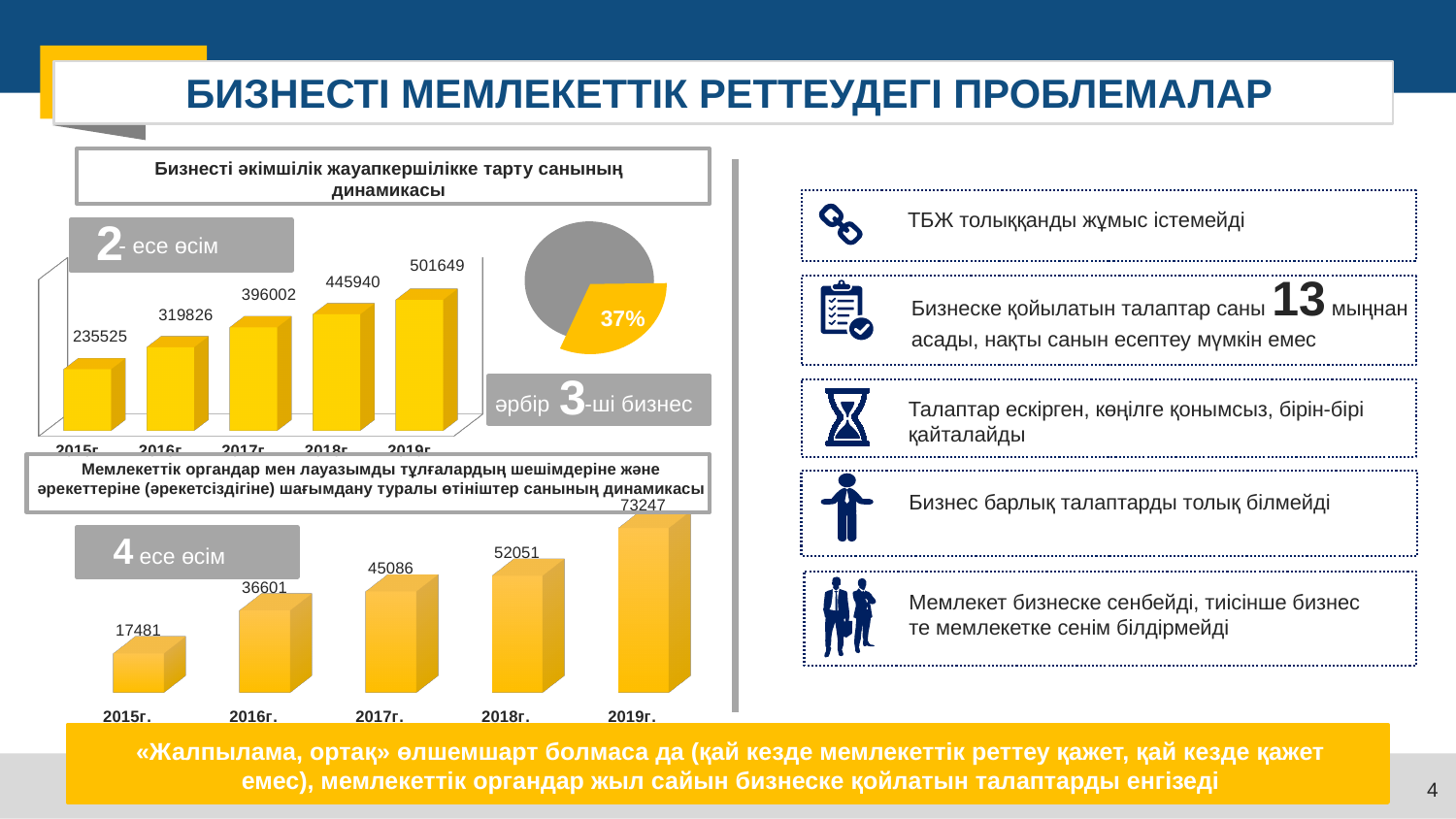
In the bottom-left bar chart, what is the value for 2016г.? 36601 In the bottom-left bar chart, what is the value for 2019г.? 73247 In the top-left bar chart, do the values rise or fall from 2015г. to 2019г.? rise In the top-left bar chart, what is the value for 2015г.? 235525 In the top-left bar chart, what is the value for 2019г.? 501649 In the bottom-left bar chart, what is the difference between the 2018г. and 2017г. values? 6965 What kind of chart is the bottom-left chart? bar chart In the top-left bar chart, which year has the lowest value? 2015г. In the bottom-left bar chart, how many years are plotted? 5 In the bottom-left bar chart, which year has the highest value? 2019г. In the top-left bar chart, what is the difference between the 2019г. and 2015г. values? 266124 In the pie chart on the left side of the slide, what percentage is shown on the highlighted yellow slice? 37%